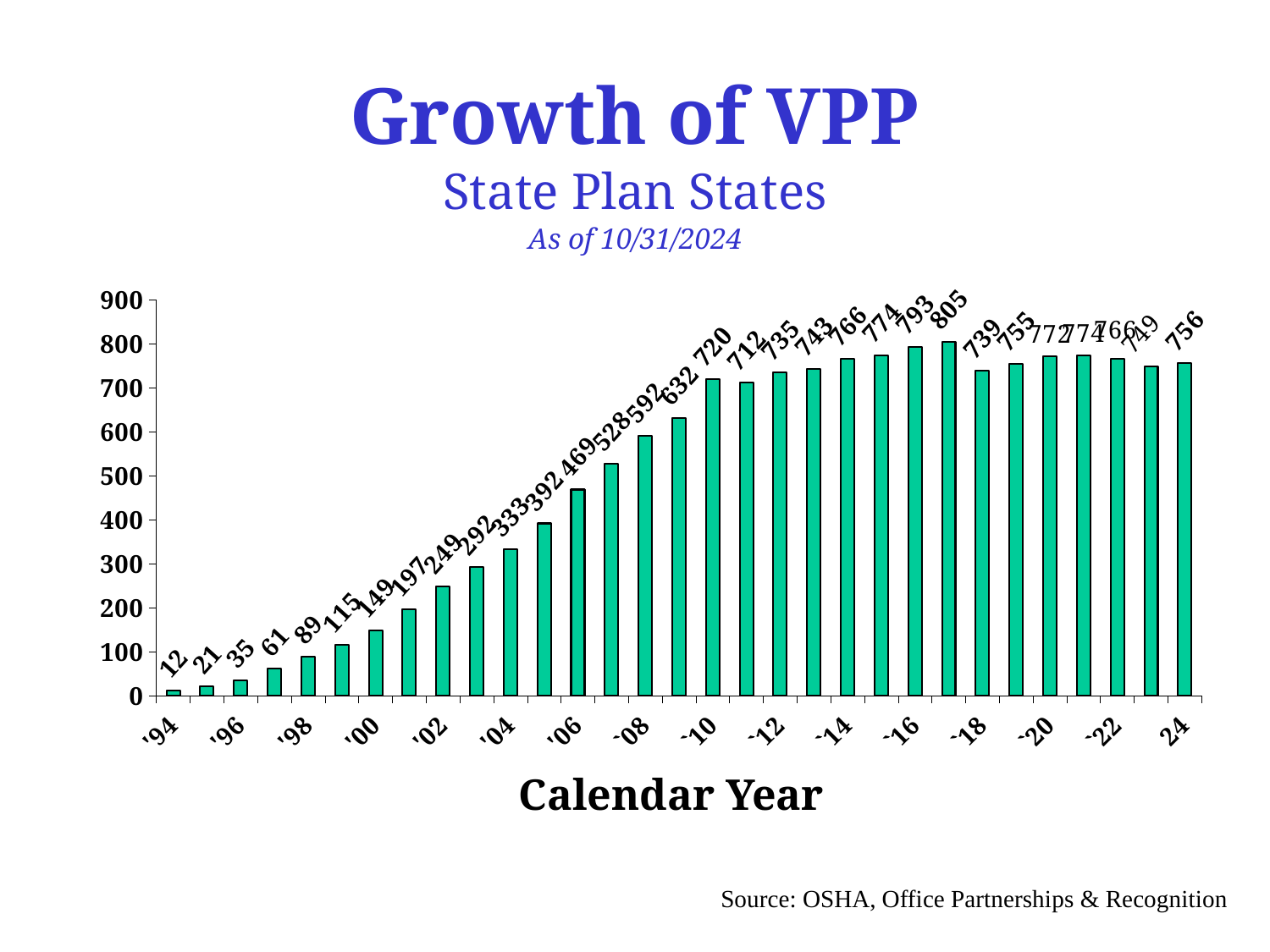
What is the value for '24? 756 Which year has the highest value? '17 Is the value for '06 greater or less than 400? greater Which is larger, the value for '16 or the value for '18? '16 What is the value for '10? 720 What kind of chart is shown? bar chart Do the values rise or fall from '94 to '17? rise Which year has the lowest value? '94 What is the value for '94? 12 How many bars are plotted in the chart? 31 What is the value for '17? 805 What is the difference between the values for '10 and '94? 708